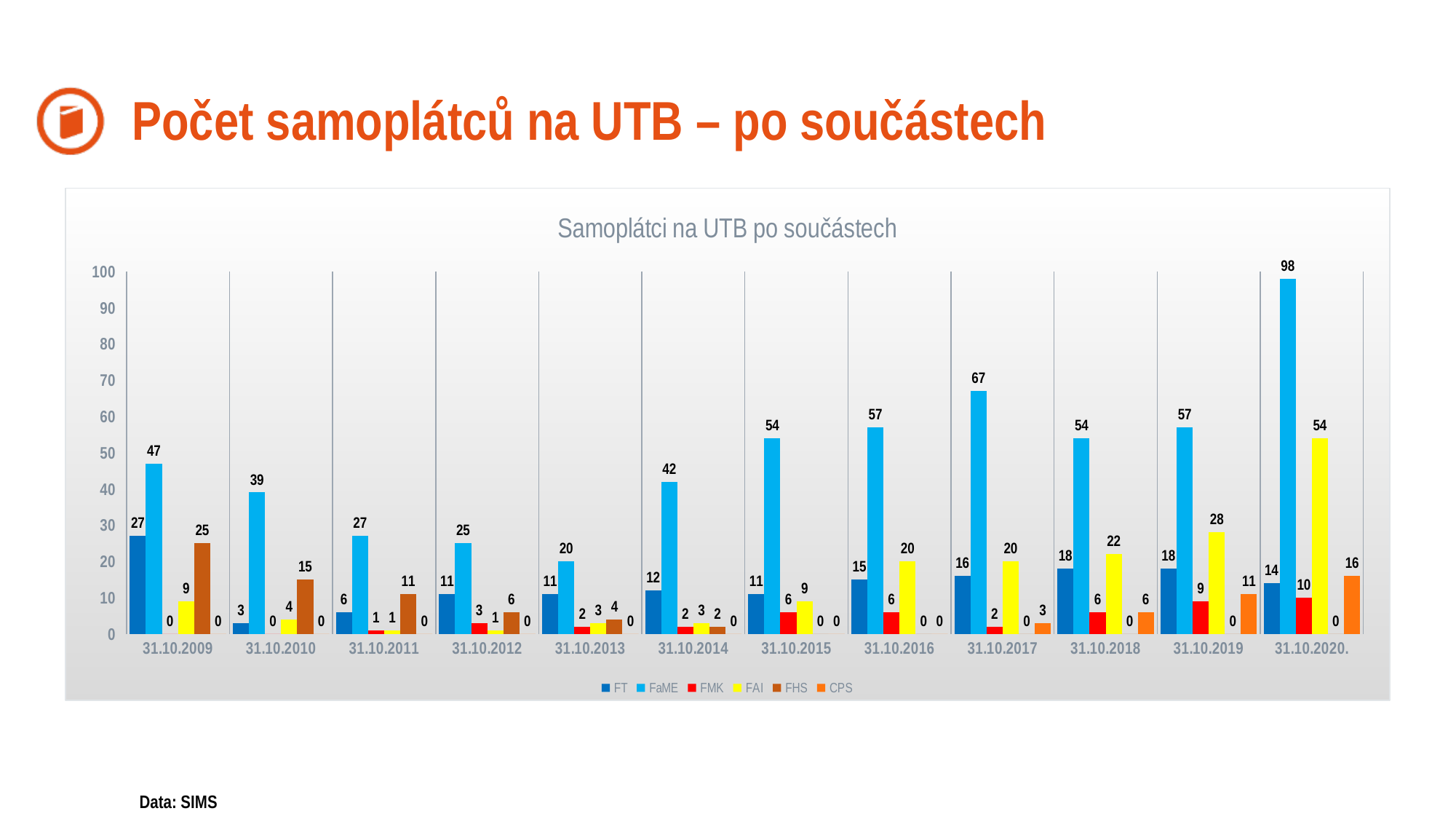
What is the value for FAI on 31.10.2019? 28 What is the title of the chart? Samoplátci na UTB po součástech What is the value for FaME on 31.10.2020? 98 What kind of chart is shown on the slide? Bar chart What is the value for FHS on 31.10.2009? 25 What is the difference between the FaME values on 31.10.2020 and 31.10.2019? 41 What is the value for CPS on 31.10.2017? 3 How many series does the legend list? 6 In which year is the FT value lowest? 31.10.2010 In which year does FaME reach its highest value? 31.10.2020 How many dates are shown on the x axis? 12 Which is larger on 31.10.2009: FT or FHS? FT